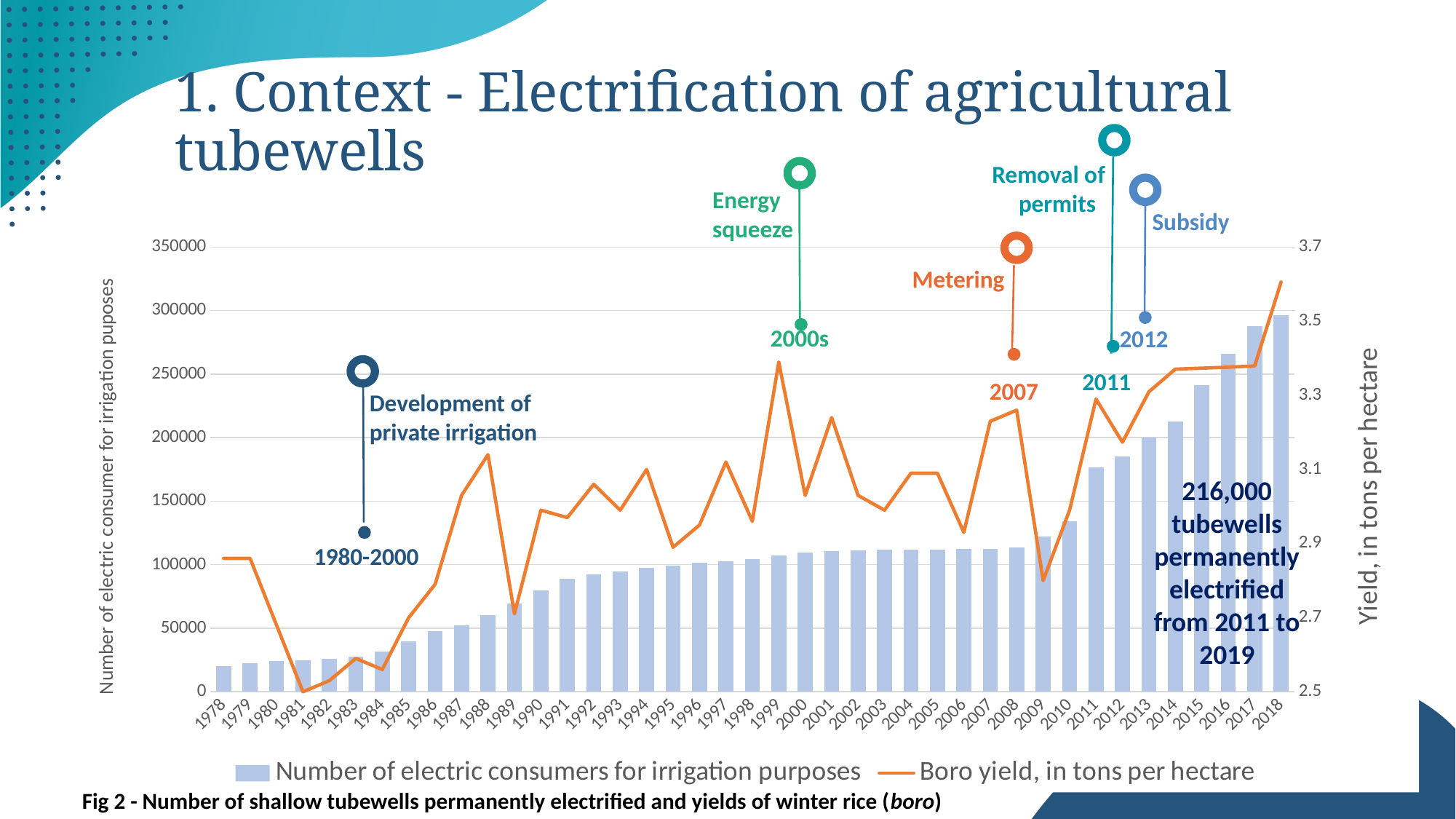
Does the number of electric consumers for irrigation purposes generally rise or fall from 1978 to 2018? rise In which year is the number of electric consumers for irrigation purposes lowest? 1978 How many years are shown along the x axis? 41 Is the number of electric consumers for irrigation purposes in 2010 greater or less than 150000? less Is the Boro yield in 2009 greater or less than 2.9 tons per hectare? less Is the number of electric consumers for irrigation purposes in 2018 greater or less than 250000? greater What is the label of the right-hand vertical axis? Yield, in tons per hectare In which year is the Boro yield lowest? 1981 In which year is the number of electric consumers for irrigation purposes highest? 2018 Which year has a larger number of electric consumers for irrigation purposes, 2005 or 2015? 2015 What kind of chart is shown on the slide? A combined bar and line chart How many series does the legend list? 2